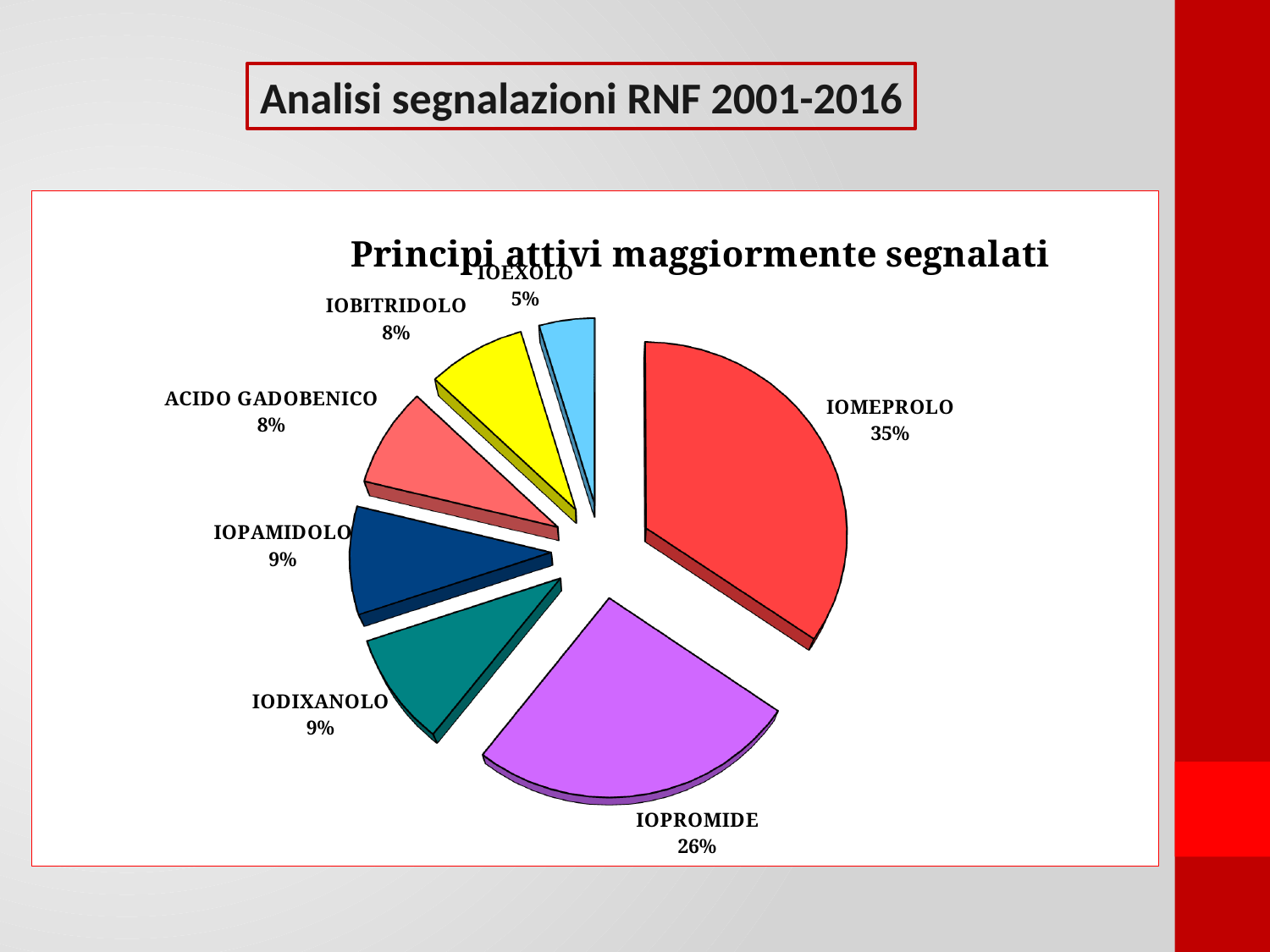
What is the difference in percentage points between IOMEPROLO and IOPROMIDE? 9 What share of the pie does IOPROMIDE have? 26% What percentage is shown for IOEXOLO? 5% What is the title of the chart? Principi attivi maggiormente segnalati Which is larger, the share for IOPAMIDOLO or the share for IOBITRIDOLO? IOPAMIDOLO What percentage is shown for ACIDO GADOBENICO? 8% What share of the pie does IOMEPROLO have? 35% Which active ingredient has the smallest slice of the pie? IOEXOLO How many slices does the pie chart have? 7 What type of chart is shown on the slide? pie chart What percentage is shown for IODIXANOLO? 9% Which active ingredient has the largest slice of the pie? IOMEPROLO